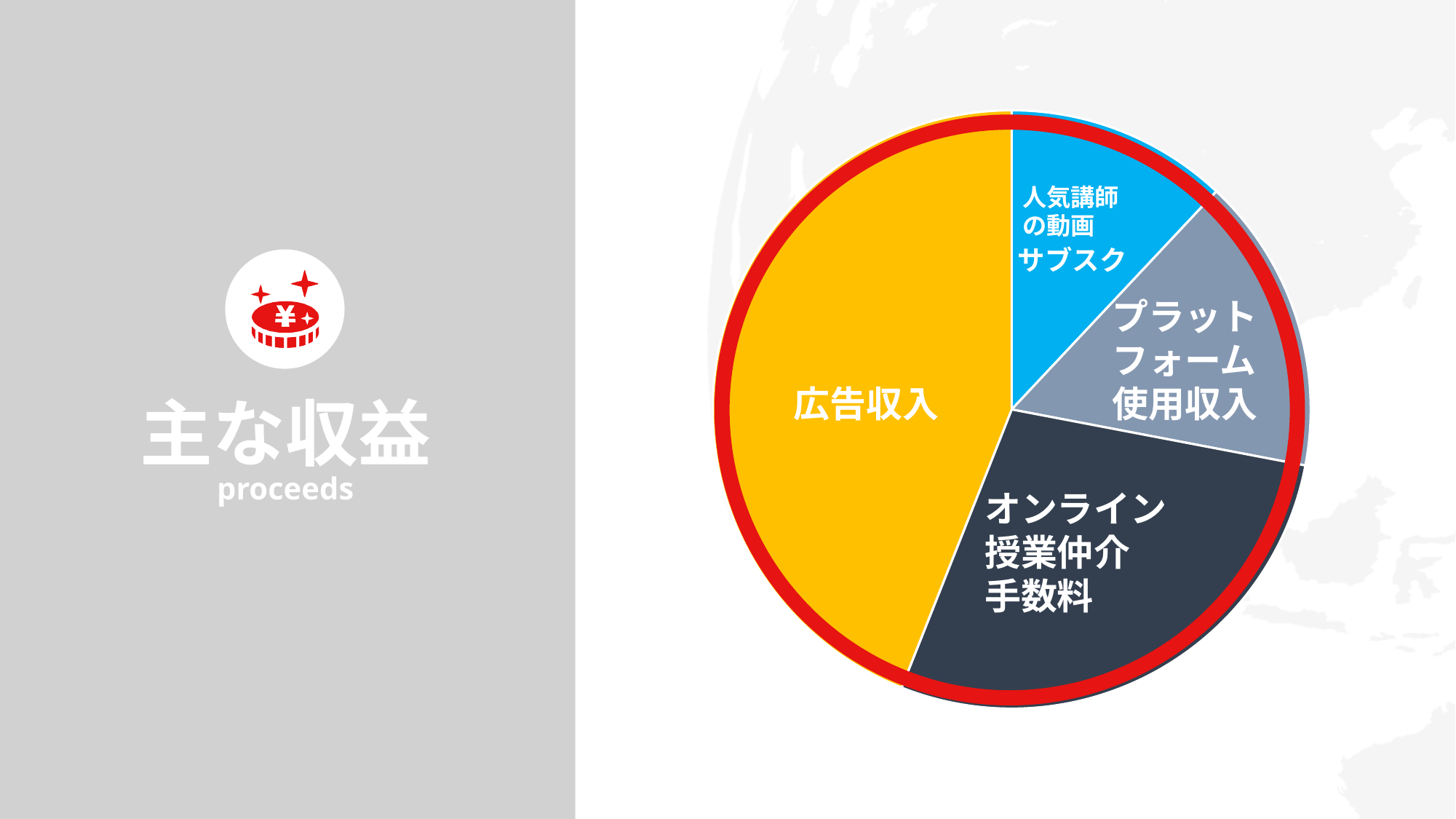
Which slice of the pie chart is the smallest? 人気講師の動画サブスク Which is larger in the pie chart, オンライン授業仲介手数料 or プラットフォーム使用収入? オンライン授業仲介手数料 Which is larger in the pie chart, 広告収入 or プラットフォーム使用収入? 広告収入 What colour is the 広告収入 slice of the pie chart? yellow Which is larger in the pie chart, 広告収入 or オンライン授業仲介手数料? 広告収入 Which slice of the pie chart is the largest? 広告収入 What kind of chart is shown on the slide? pie chart What colour is the 人気講師の動画サブスク slice of the pie chart? light blue How many slices does the pie chart have? 4